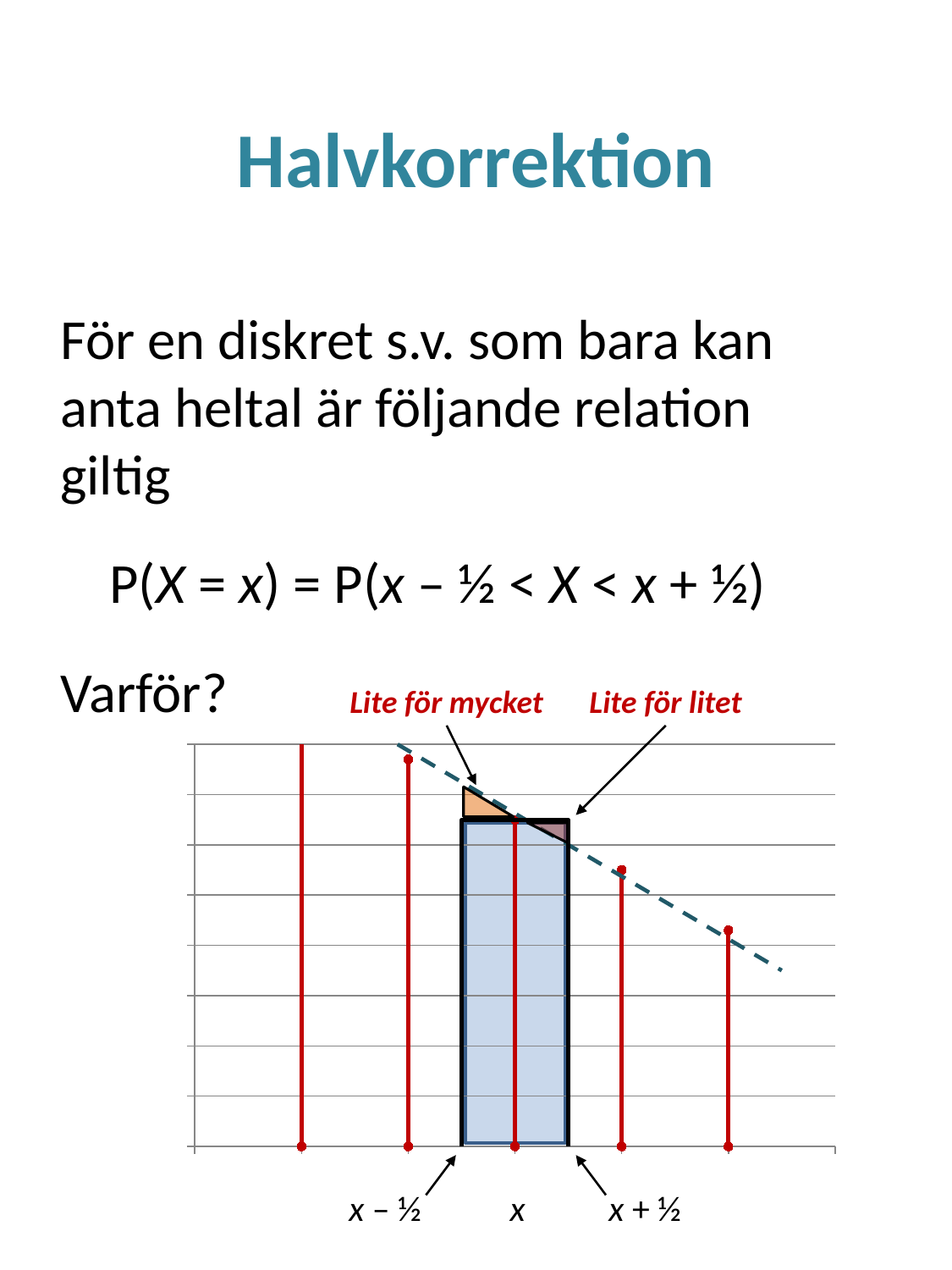
What are the three labels printed below the x axis of the chart? x − ½, x, x + ½ What text labels the small orange triangle above the shaded rectangle? Lite för mycket How many red vertical stems (data points) are plotted in the chart? 5 Which x-axis label marks the left edge of the shaded rectangle? x − ½ Do the heights of the red stems rise or fall from left to right along the x axis? fall Which x-axis label marks the right edge of the shaded rectangle? x + ½ What text labels the small grey triangle at the top right of the shaded rectangle? Lite för litet Which is taller: the red stem at x or the red stem immediately to its right? the red stem at x Which red stem is the tallest: the leftmost one or the rightmost one? the leftmost one Which red stem is the shortest in the chart? the rightmost one